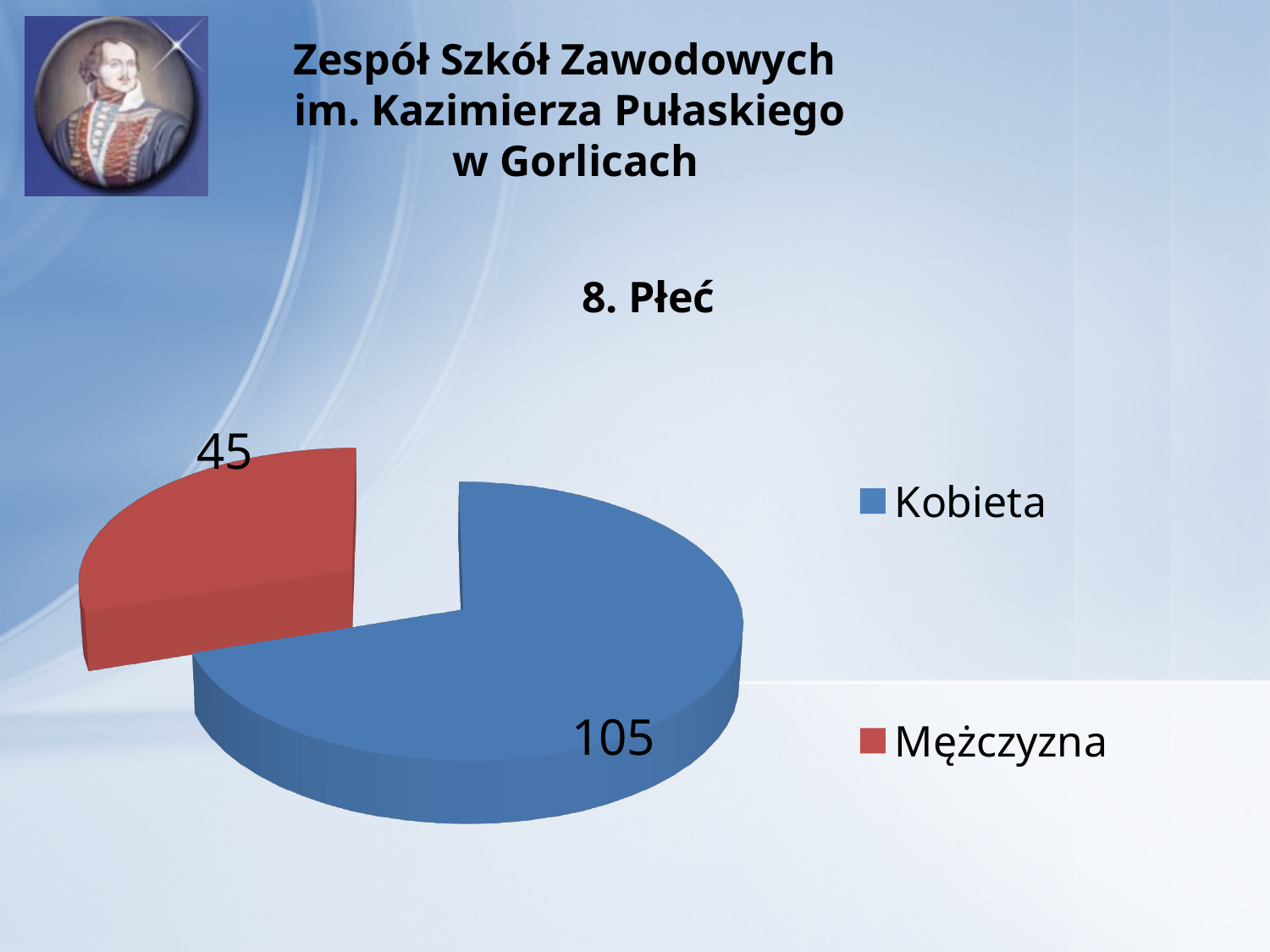
What kind of chart is shown on the slide? pie chart How many categories does the pie chart show? 2 What share of the pie does Kobieta represent? 70% What is the title of the chart? 8. Płeć What is the value for Kobieta? 105 What is the difference between the values for Kobieta and Mężczyzna? 60 Which category has the smallest slice? Mężczyzna What is the total of all slices in the pie chart? 150 What is the value for Mężczyzna? 45 Which category has the largest slice? Kobieta Which is larger, Kobieta or Mężczyzna? Kobieta What colour is the Mężczyzna slice? red